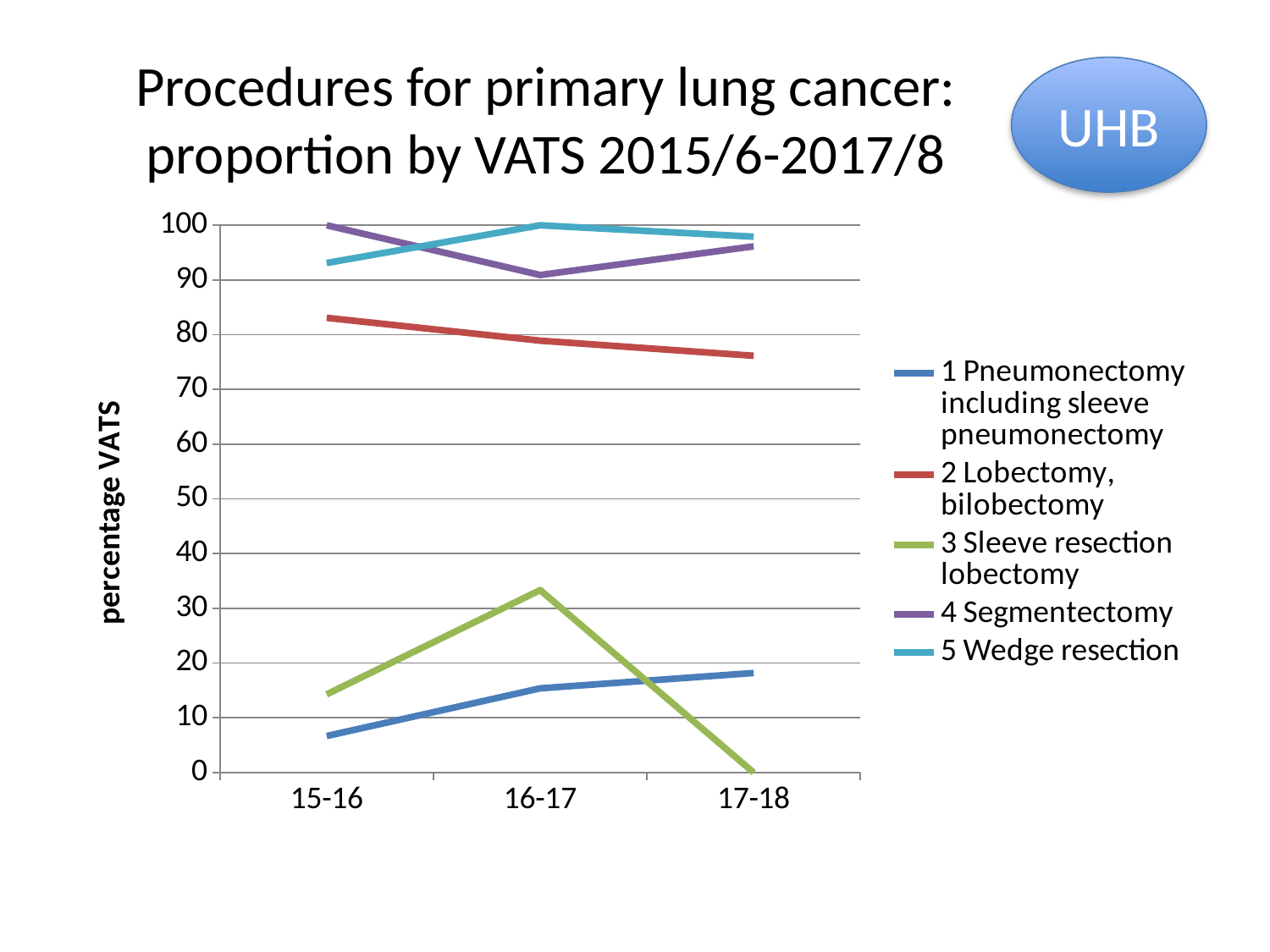
What kind of chart is shown on the slide? line chart What is the value for 4 Segmentectomy in 15-16? 100 Is the value for 2 Lobectomy, bilobectomy in 15-16 greater or less than 80? greater How many series does the legend list? 5 Is the value for 3 Sleeve resection lobectomy in 16-17 greater or less than 30? greater Is the value for 1 Pneumonectomy including sleeve pneumonectomy in 15-16 greater or less than 10? less Does the value for 2 Lobectomy, bilobectomy rise or fall from 15-16 to 17-18? fall What is the value for 5 Wedge resection in 16-17? 100 What is the label of the y axis? percentage VATS What is the value for 3 Sleeve resection lobectomy in 17-18? 0 How many time periods are shown on the x axis? 3 Which series has the lowest value in 17-18? 3 Sleeve resection lobectomy